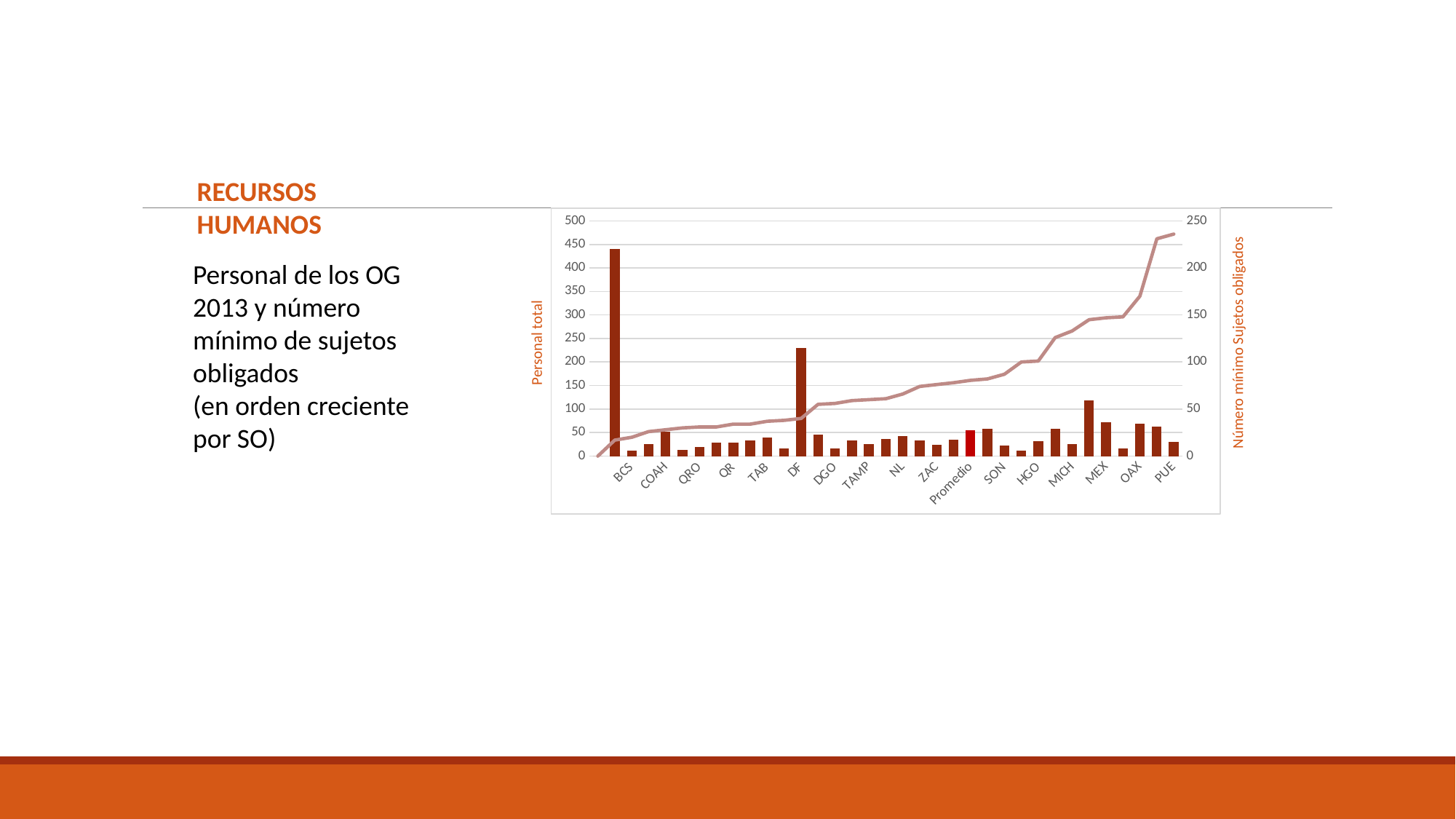
On the right axis, is the line value at PUE greater or less than 200? greater Which category's bar is highlighted in red? Promedio What kind of chart is shown on the slide? A combined bar and line chart What is the title of the left vertical axis? Personal total Is the Personal total bar for BCS greater or less than 400? less Which has a larger Personal total bar, BCS or DF? DF Is the Personal total bar for Promedio greater or less than 100? less Does the line for Número mínimo Sujetos obligados rise or fall from left to right? It rises